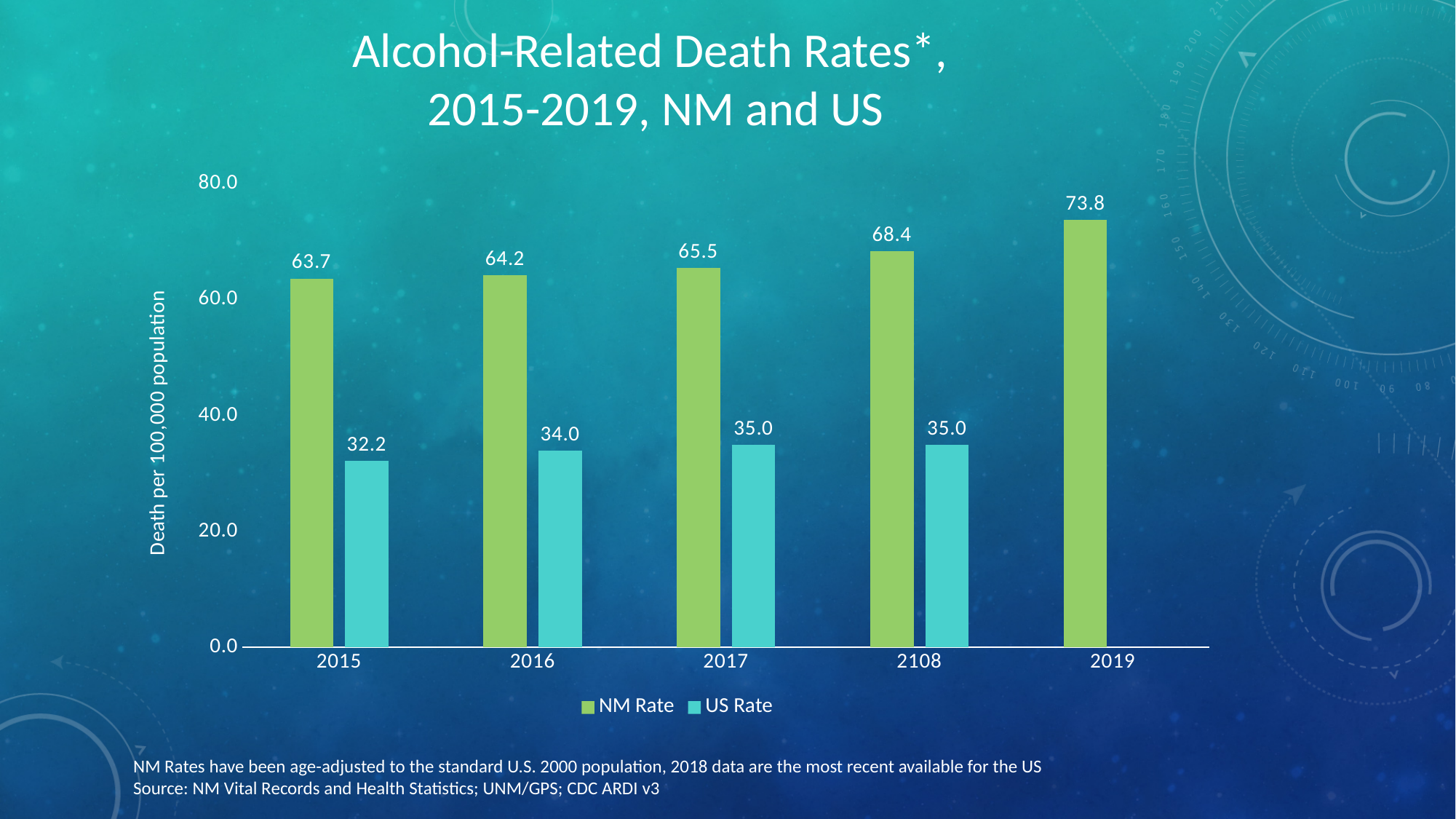
Which year has the highest NM Rate? 2019 How many series does the legend list? 2 What is the difference between the NM Rate and the US Rate in 2016? 30.2 What is the NM Rate for 2017? 65.5 What is the US Rate for 2015? 32.2 What kind of chart is shown on the slide? bar chart What is the NM Rate for 2019? 73.8 Is the NM Rate for 2019 greater or less than 60.0? greater How many years are shown on the x axis? 5 Does the NM Rate rise or fall from 2015 to 2019? rise Which is larger in 2015, the NM Rate or the US Rate? NM Rate Which year has the lowest US Rate? 2015